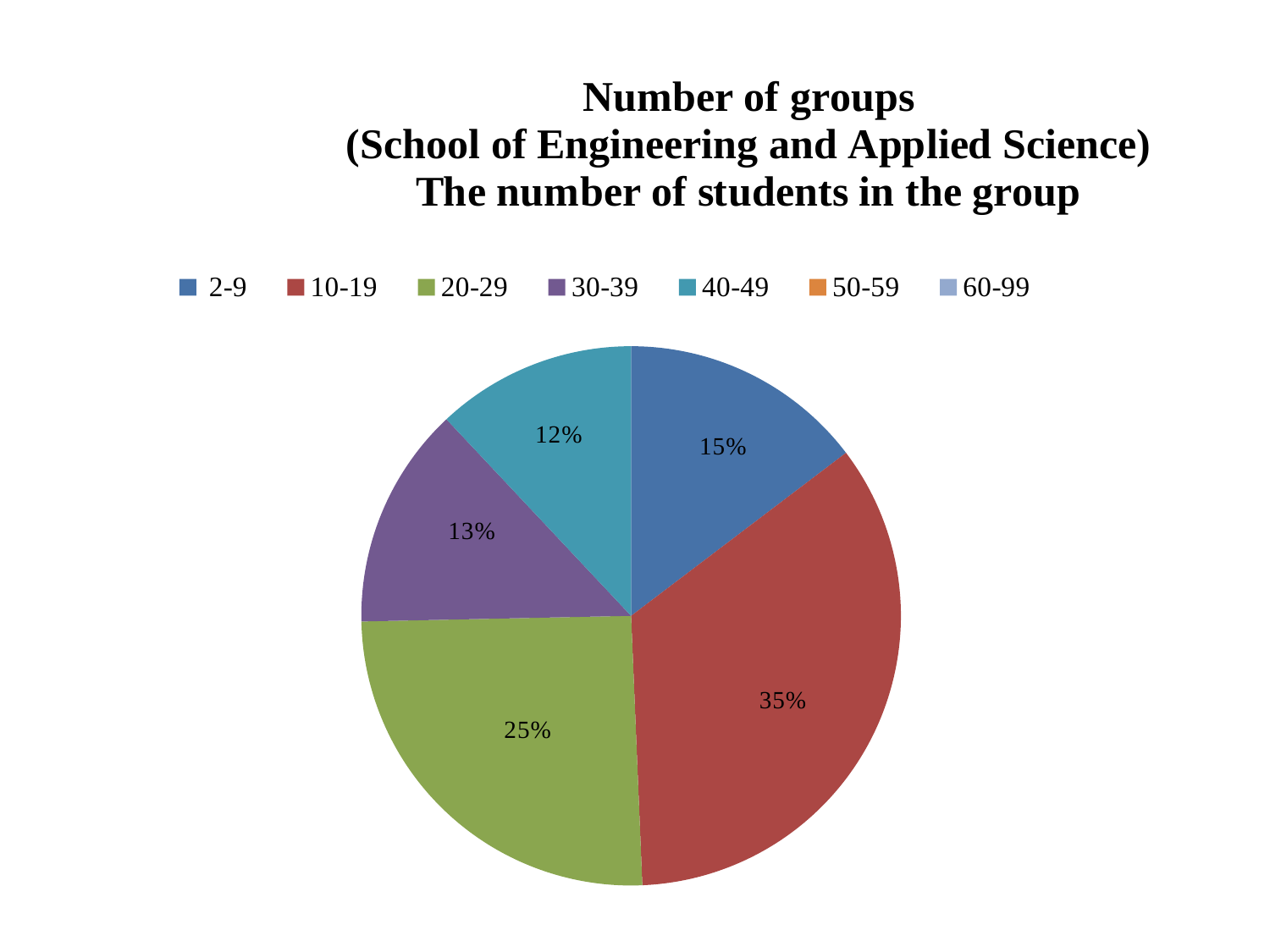
Which of the labelled slices is the smallest? 40-49 What share of the pie does the 30-39 group have? 13% How many entries does the legend list? 7 What share of the pie does the 40-49 group have? 12% What share of the pie does the 2-9 group have? 15% Which has a larger share, the 2-9 group or the 30-39 group? 2-9 Which group has the largest slice of the pie? 10-19 What kind of chart is shown on the slide? pie chart What is the difference between the shares of the 10-19 group and the 20-29 group? 10% What colour is the slice for the 20-29 group? green